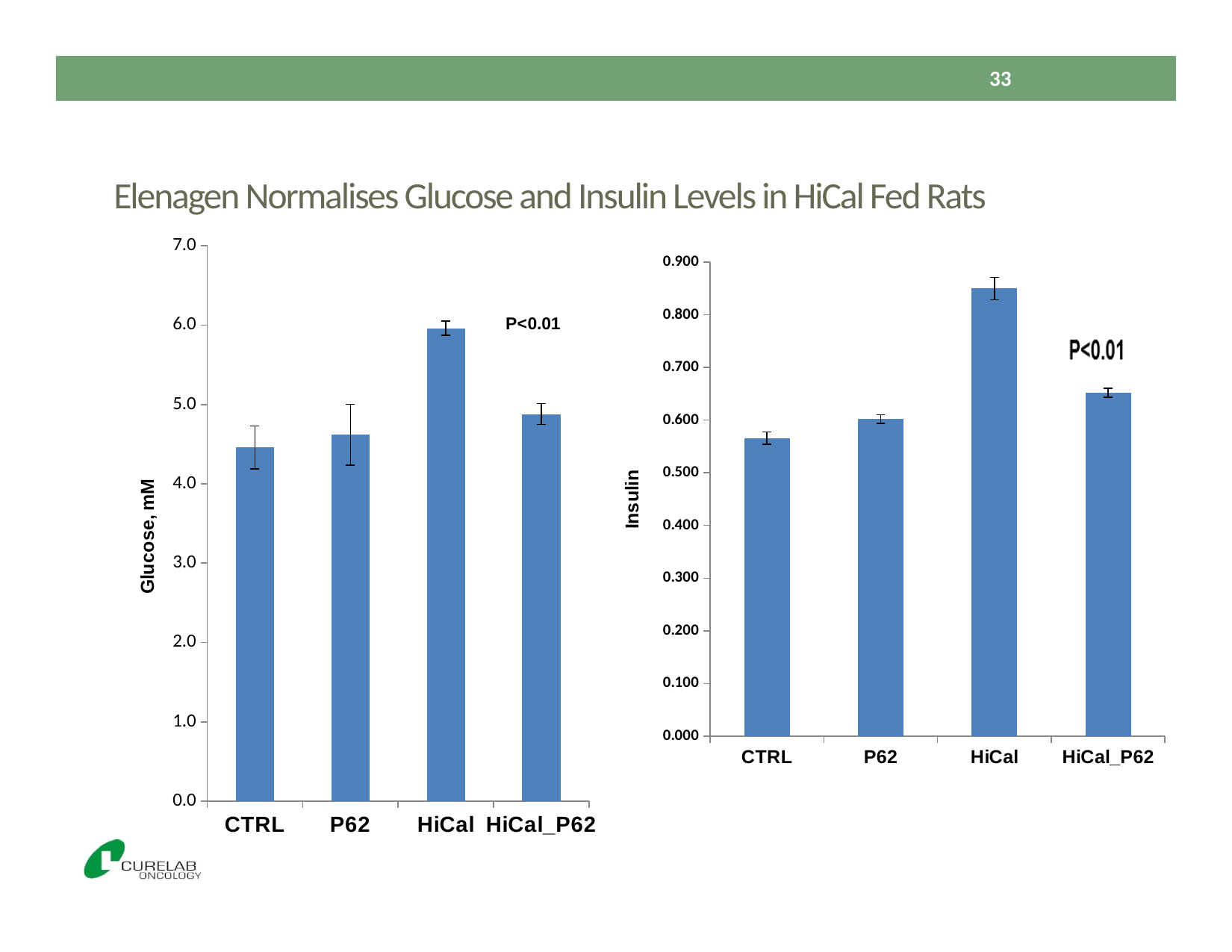
In the right chart (Insulin), is the value for HiCal greater or less than 0.800? greater What is the y-axis label of the left chart? Glucose, mM What kind of chart is the left chart with the y-axis labelled Glucose, mM? bar chart In the left chart (Glucose, mM), is the value for HiCal greater or less than 5.0? greater In the right chart (Insulin), is the value for HiCal_P62 greater or less than 0.700? less In the right chart (Insulin), which is larger, the value for P62 or the value for HiCal_P62? HiCal_P62 In the left chart (Glucose, mM), which category has the highest value? HiCal In the right chart (Insulin), which category has the lowest value? CTRL How many categories are shown on the x axis of the left chart (Glucose, mM)? 4 In the right chart (Insulin), which category has the highest value? HiCal In the left chart (Glucose, mM), which is larger, the value for HiCal or the value for HiCal_P62? HiCal